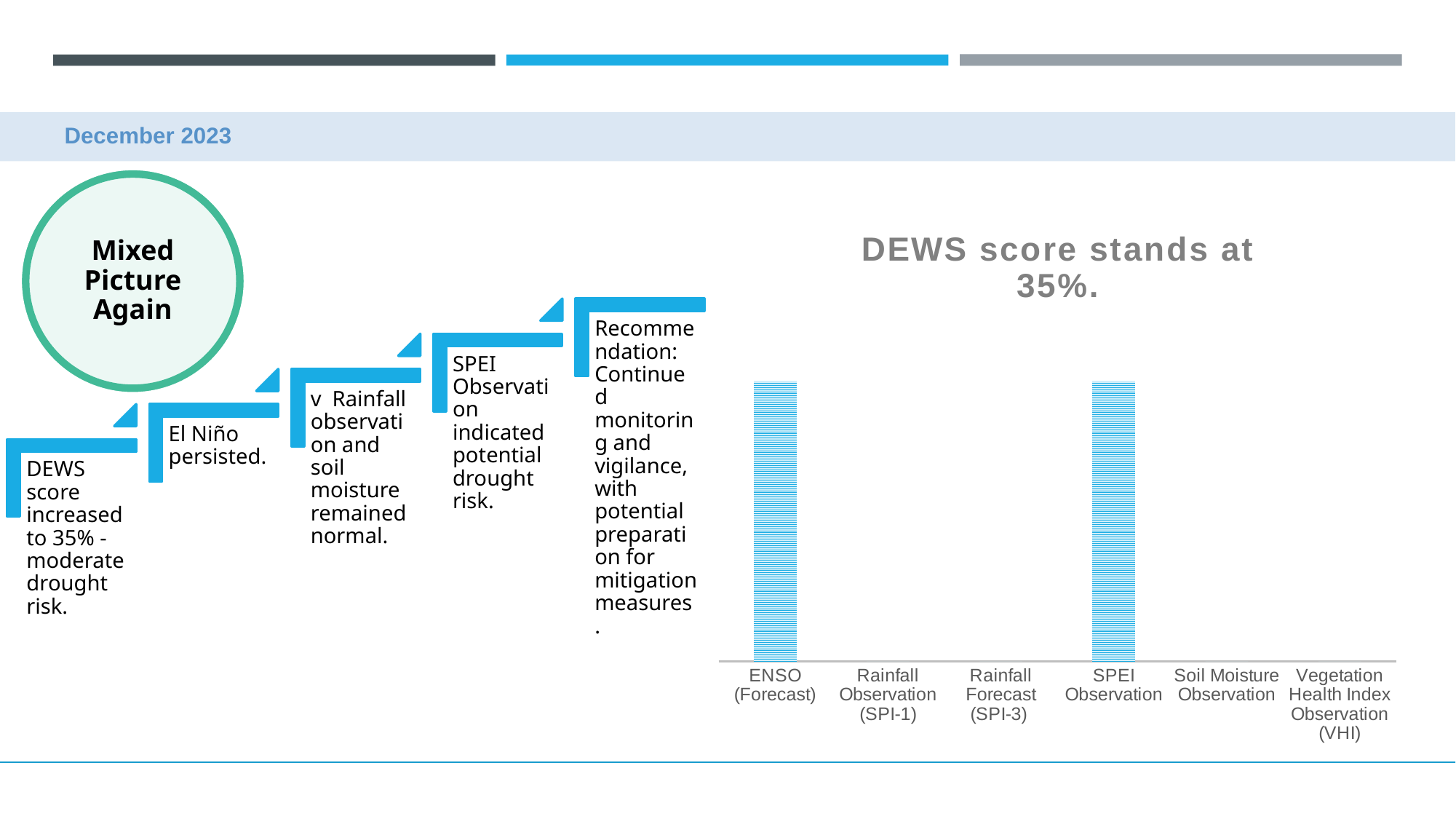
Which is larger in the chart, the value for SPEI Observation or the value for Soil Moisture Observation? SPEI Observation According to the chart title, what is the DEWS score? 35% Which is larger in the chart, the value for Rainfall Forecast (SPI-3) or the value for SPEI Observation? SPEI Observation Which is larger in the chart, the value for ENSO (Forecast) or the value for Vegetation Health Index Observation (VHI)? ENSO (Forecast) What is the first category on the x axis of the chart? ENSO (Forecast) What is the title of the chart? DEWS score stands at 35%. Which two categories in the chart have visible bars? ENSO (Forecast) and SPEI Observation What kind of chart is shown on the right of the slide? bar chart How many categories are listed along the x axis of the chart? 6